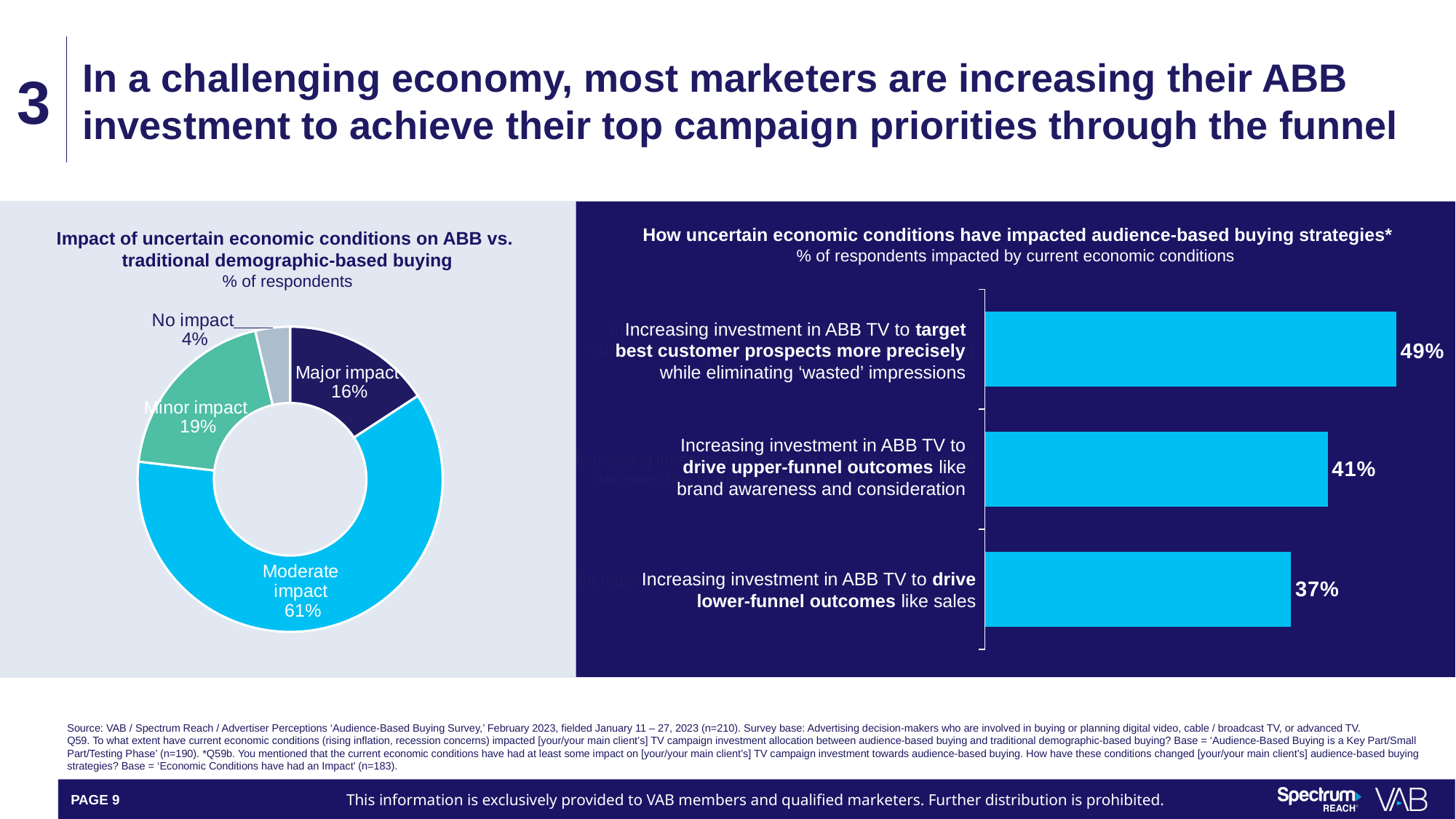
In the 'Impact of uncertain economic conditions on ABB vs. traditional demographic-based buying' chart, what is the difference between the Minor impact and Major impact shares? 3 percentage points What kind of chart is the 'How uncertain economic conditions have impacted audience-based buying strategies' chart? Bar chart In the 'How uncertain economic conditions have impacted audience-based buying strategies' chart, what percentage of respondents are increasing investment in ABB TV to drive upper-funnel outcomes? 41% In the 'Impact of uncertain economic conditions on ABB vs. traditional demographic-based buying' chart, what percentage of respondents reported a moderate impact? 61% What kind of chart is the 'Impact of uncertain economic conditions on ABB vs. traditional demographic-based buying' chart? Donut (pie) chart In the 'Impact of uncertain economic conditions on ABB vs. traditional demographic-based buying' chart, what percentage of respondents reported a major impact? 16% In the 'Impact of uncertain economic conditions on ABB vs. traditional demographic-based buying' chart, how many categories are shown? 4 In the 'Impact of uncertain economic conditions on ABB vs. traditional demographic-based buying' chart, which category has the smallest share? No impact In the 'How uncertain economic conditions have impacted audience-based buying strategies' chart, which strategy has the highest percentage? Increasing investment in ABB TV to target best customer prospects more precisely while eliminating 'wasted' impressions In the 'How uncertain economic conditions have impacted audience-based buying strategies' chart, what is the difference between the highest and lowest values? 12 percentage points In the 'How uncertain economic conditions have impacted audience-based buying strategies' chart, what percentage of respondents are increasing investment in ABB TV to drive lower-funnel outcomes like sales? 37% In the 'Impact of uncertain economic conditions on ABB vs. traditional demographic-based buying' chart, which category has the largest share? Moderate impact